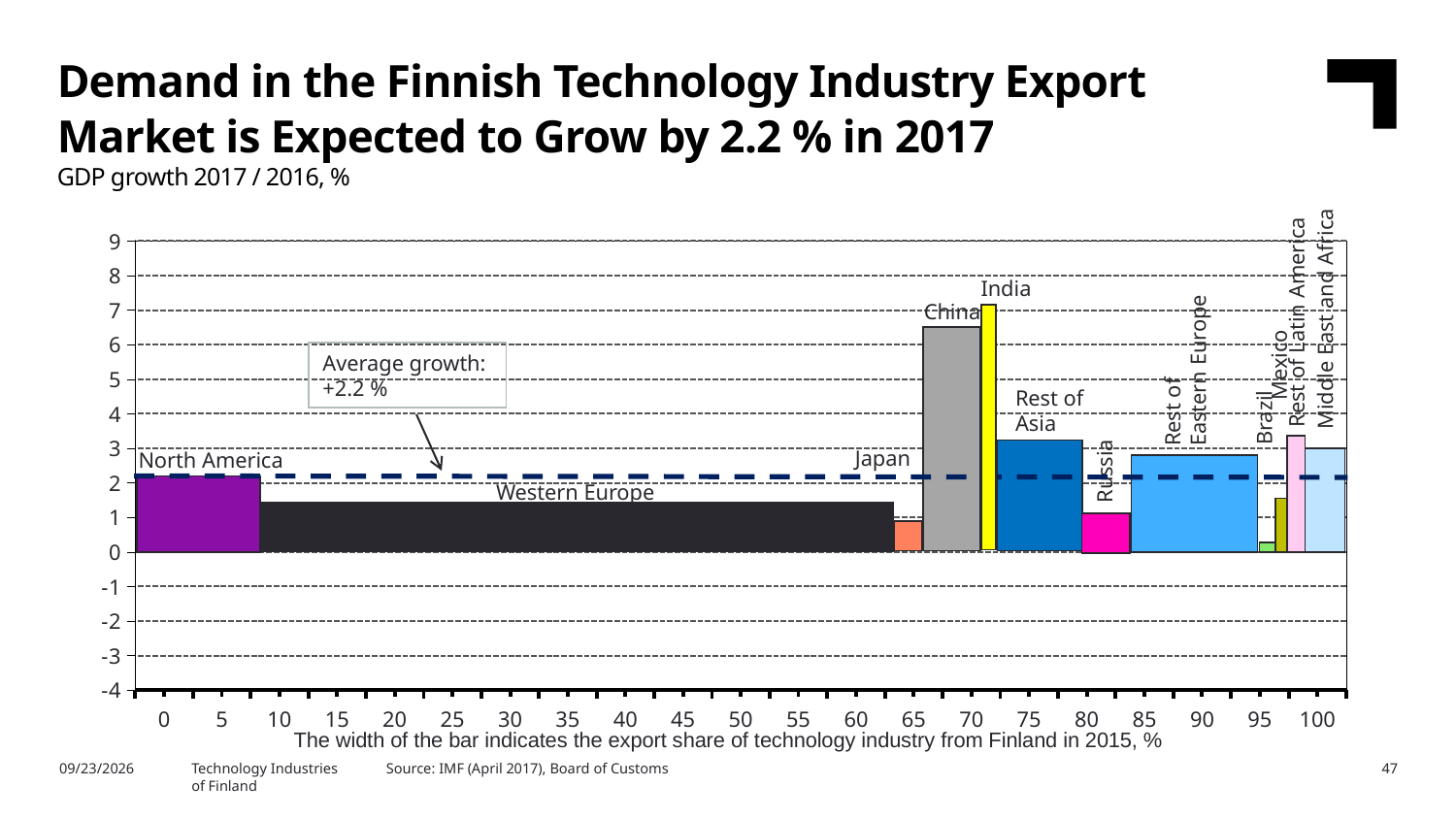
Is the value for China greater or less than 5? greater Is the value for Brazil greater or less than 1? less According to the note below the x axis, what does the width of each bar indicate? The export share of technology industry from Finland in 2015 Is the value for Russia greater or less than 2? less Which is larger, the value for China or the value for Rest of Asia? China Which is larger, the value for North America or the value for Western Europe? North America Which region has the highest GDP growth in the chart? India What kind of chart is shown on the slide? bar chart What average growth value is printed in the annotation box on the chart? +2.2 % Which region has the lowest GDP growth in the chart? Brazil